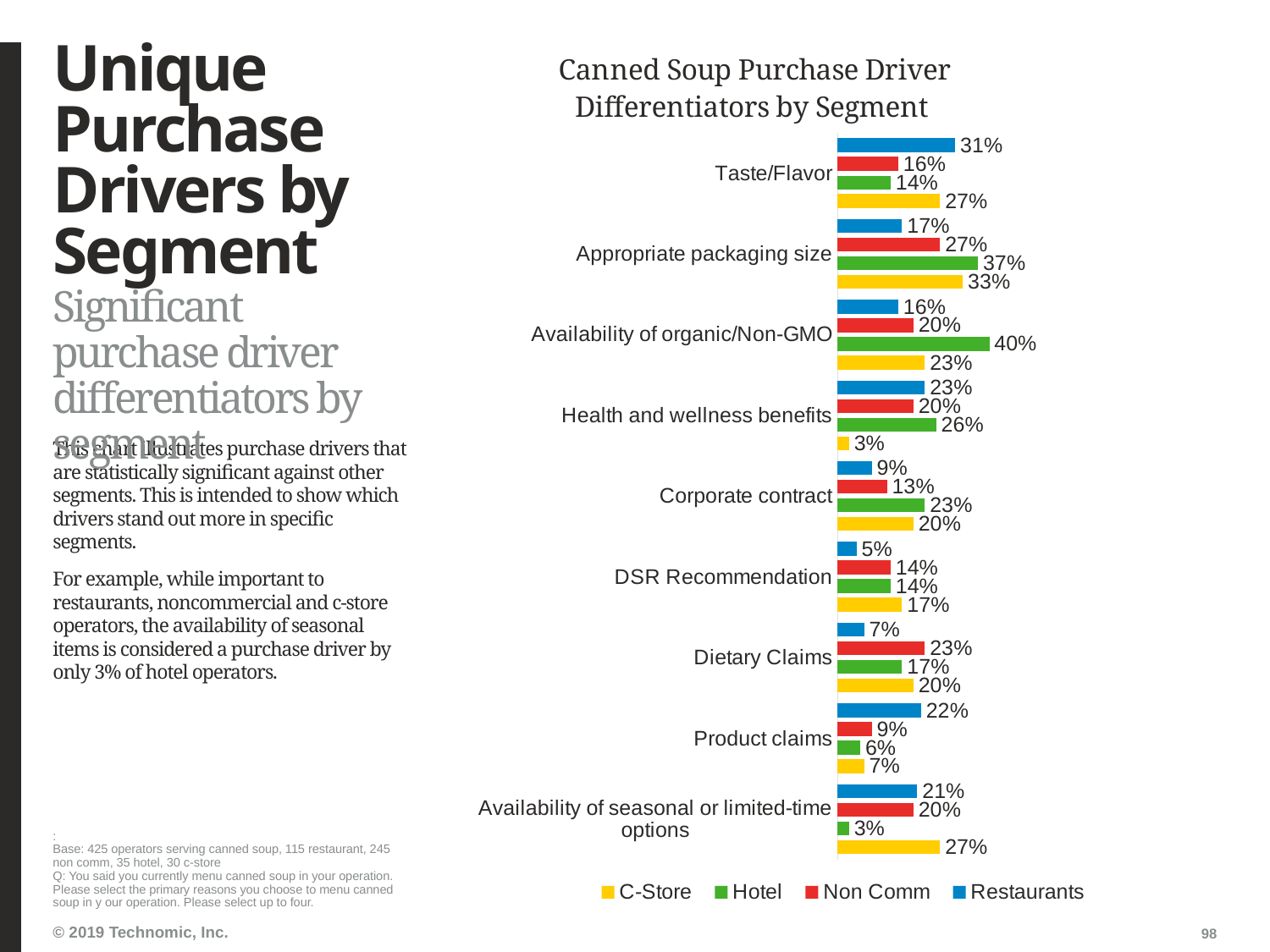
For Product claims, which is larger: the Restaurants value or the Non Comm value? Restaurants How many series does the legend list? 4 What is the Non Comm value for Dietary Claims? 23% What is the difference between the Hotel and Restaurants values for Appropriate packaging size? 20% What is the Hotel value for Availability of organic/Non-GMO? 40% What is the title of the chart? Canned Soup Purchase Driver Differentiators by Segment How many categories are shown on the chart? 9 Which category has the lowest Restaurants value? DSR Recommendation Which category has the highest Hotel value? Availability of organic/Non-GMO What is the C-Store value for Health and wellness benefits? 3% What kind of chart is shown on the slide? Bar chart What is the Restaurants value for Taste/Flavor? 31%